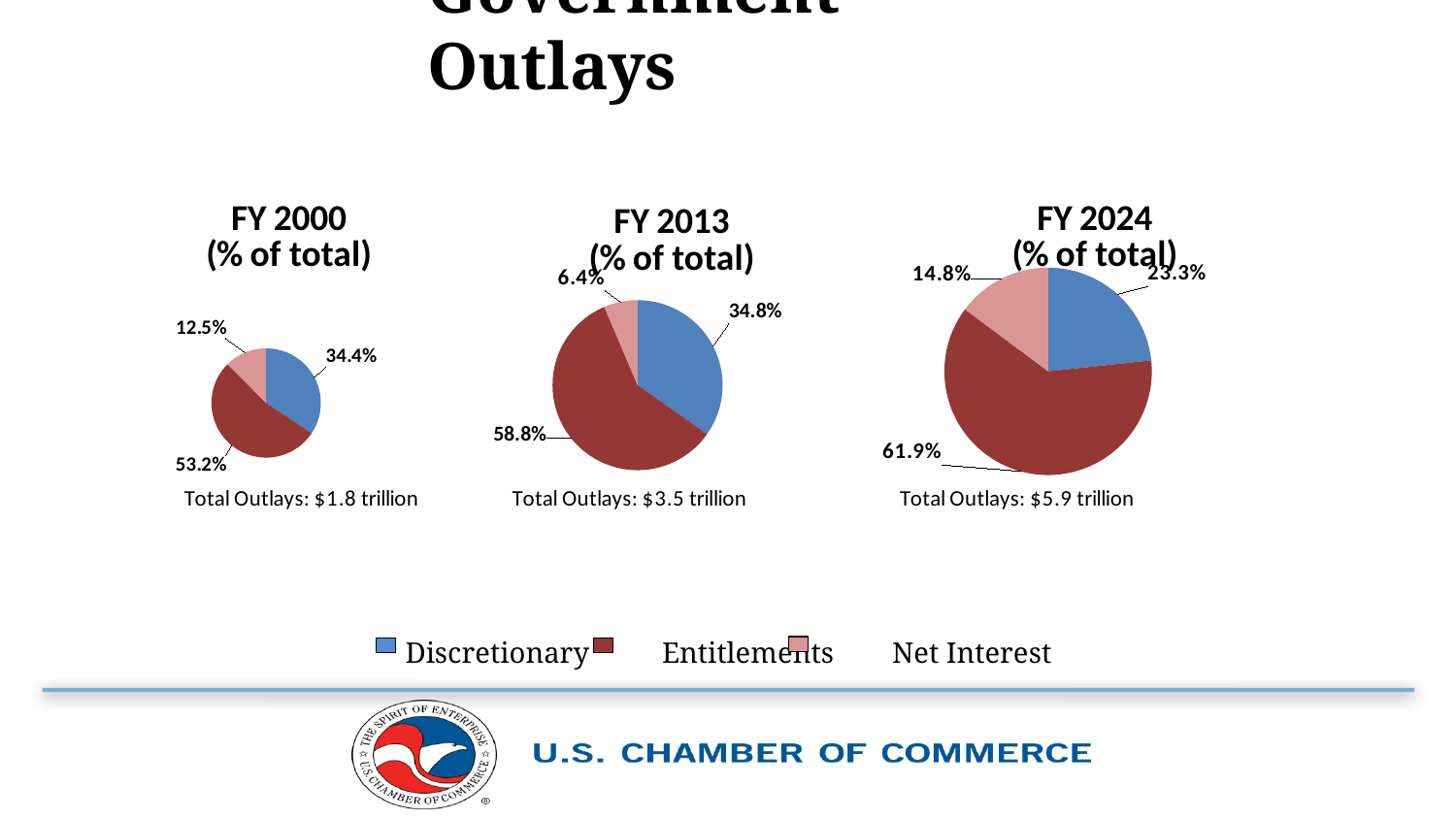
What total outlays figure is shown beneath the FY 2024 pie chart? $5.9 trillion In the FY 2024 pie chart, what share of total outlays is Discretionary? 23.3% Which colour represents Discretionary in the pie charts? Blue In the FY 2013 pie chart, what share of total outlays is Net Interest? 6.4% In the FY 2000 pie chart, what is the difference between the Entitlements share and the Discretionary share? 18.8% Is the Net Interest share larger in the FY 2000 pie chart or the FY 2013 pie chart? FY 2000 What type of chart is used to show the FY 2013 outlays? Pie chart In the FY 2000 pie chart, what share of total outlays is Entitlements? 53.2% In the FY 2024 pie chart, which category has the largest share? Entitlements How many categories does the legend list for the pie charts? 3 In the FY 2013 pie chart, which category has the smallest share? Net Interest How many pie charts are shown on the slide? 3